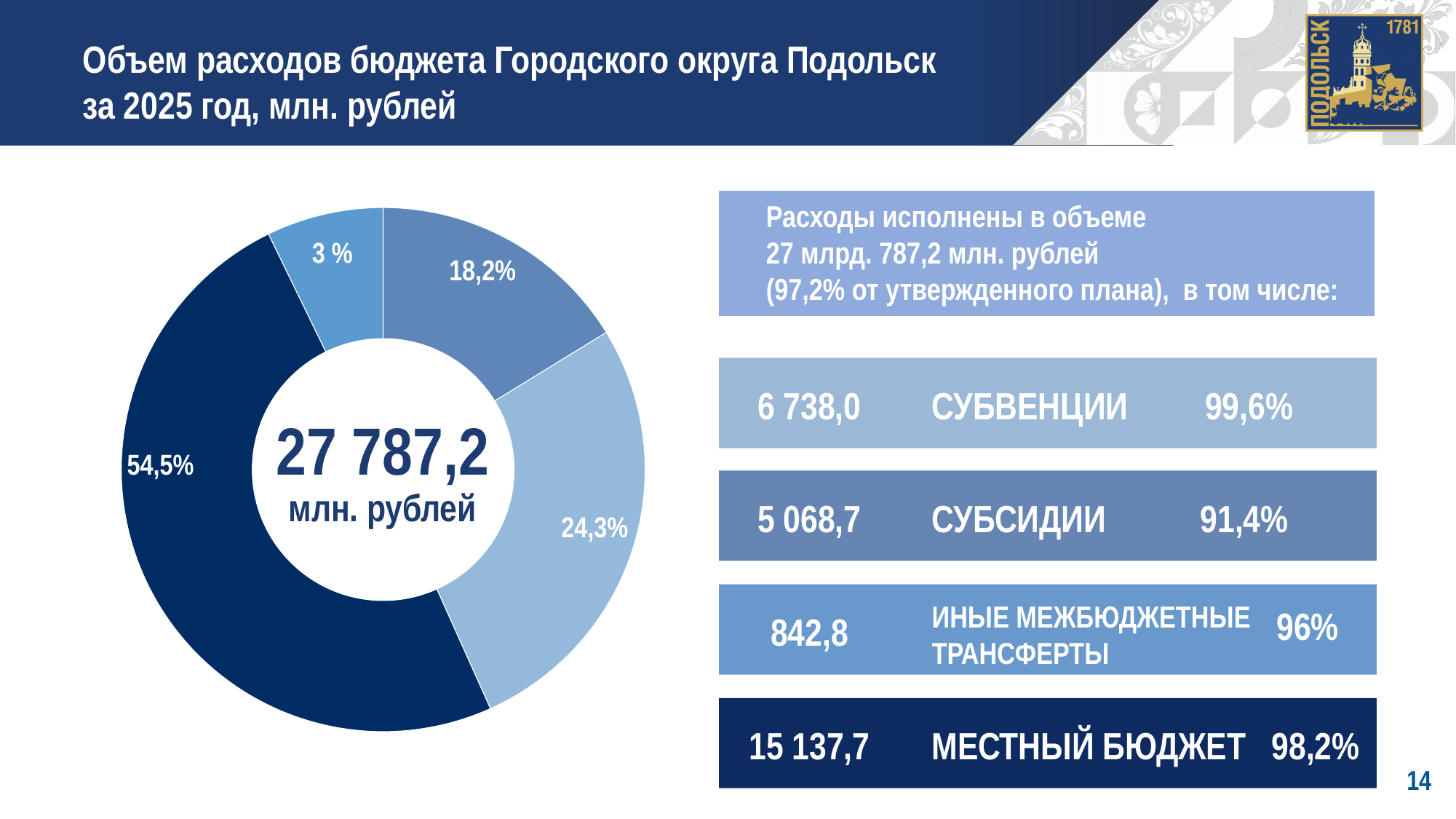
What share is shown for the light blue slice on the right side of the donut chart? 24,3% What is the combined share of the 18,2% and 3 % slices? 21,2% Is the share of the largest slice greater or less than 50%? greater What share is shown for the dark navy slice of the donut chart? 54,5% What is the title of the slide containing the donut chart? Объем расходов бюджета Городского округа Подольск за 2025 год, млн. рублей What total value is printed in the centre of the donut chart? 27 787,2 млн. рублей What is the smallest share shown on the donut chart? 3 % Which slice is larger: the one labelled 18,2% or the one labelled 24,3%? 24,3% What is the difference in percentage points between the 54,5% slice and the 24,3% slice? 30,2 What is the largest share shown on the donut chart? 54,5% What kind of chart is shown on the slide? Pie (donut) chart How many slices does the donut chart have? 4